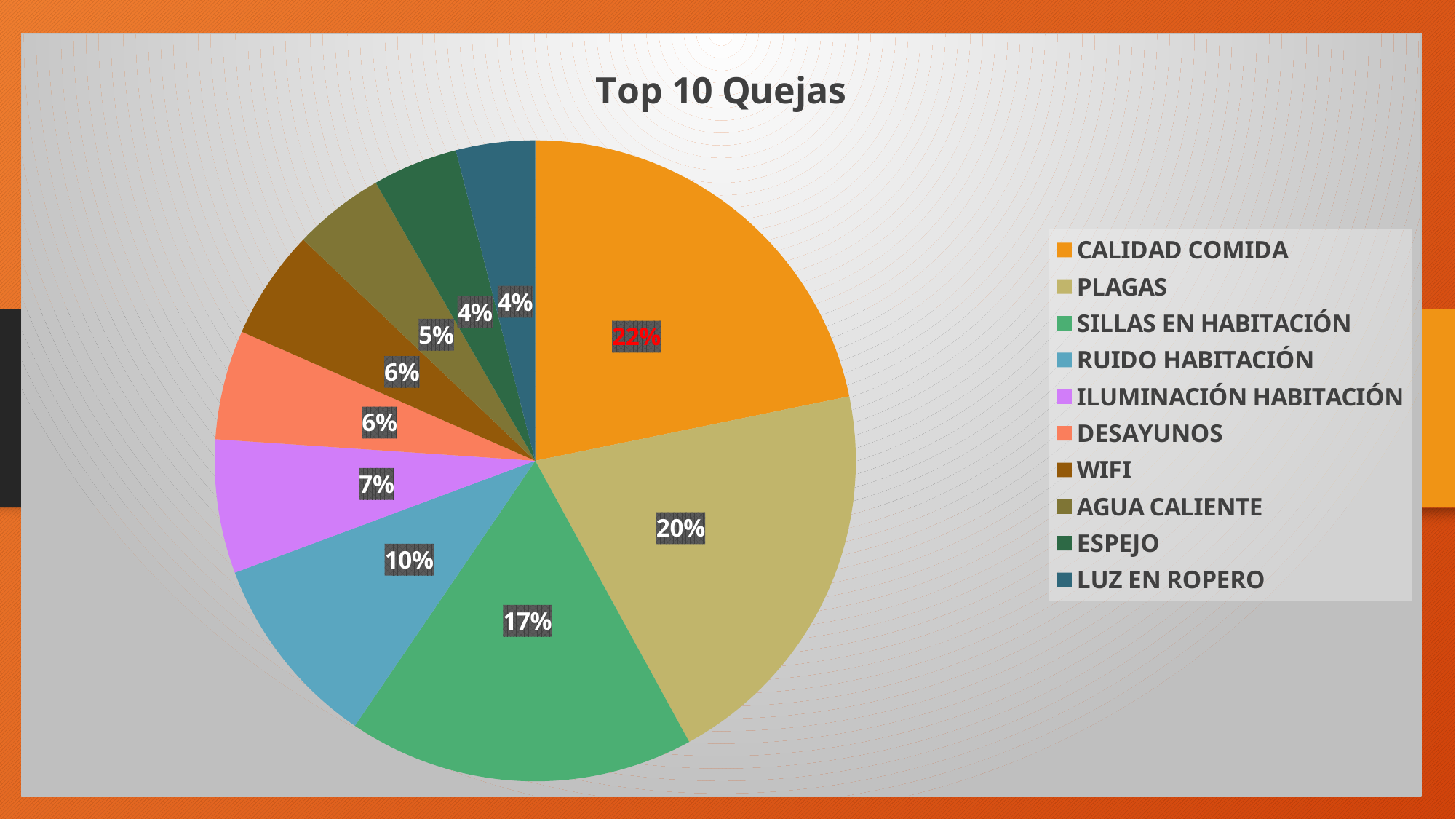
What percentage is shown for RUIDO HABITACIÓN? 10% What percentage is shown for SILLAS EN HABITACIÓN? 17% What percentage is shown for AGUA CALIENTE? 5% What percentage is shown for PLAGAS? 20% What is the title of the chart? Top 10 Quejas Which is larger, the slice for ILUMINACIÓN HABITACIÓN or the slice for RUIDO HABITACIÓN? RUIDO HABITACIÓN What is the difference in percentage points between SILLAS EN HABITACIÓN and ESPEJO? 13 Which category has the largest slice of the pie? CALIDAD COMIDA What share of the pie does CALIDAD COMIDA represent? 22% How many categories does the legend list? 10 What kind of chart is shown on the slide? Pie chart What is the difference in percentage points between CALIDAD COMIDA and PLAGAS? 2